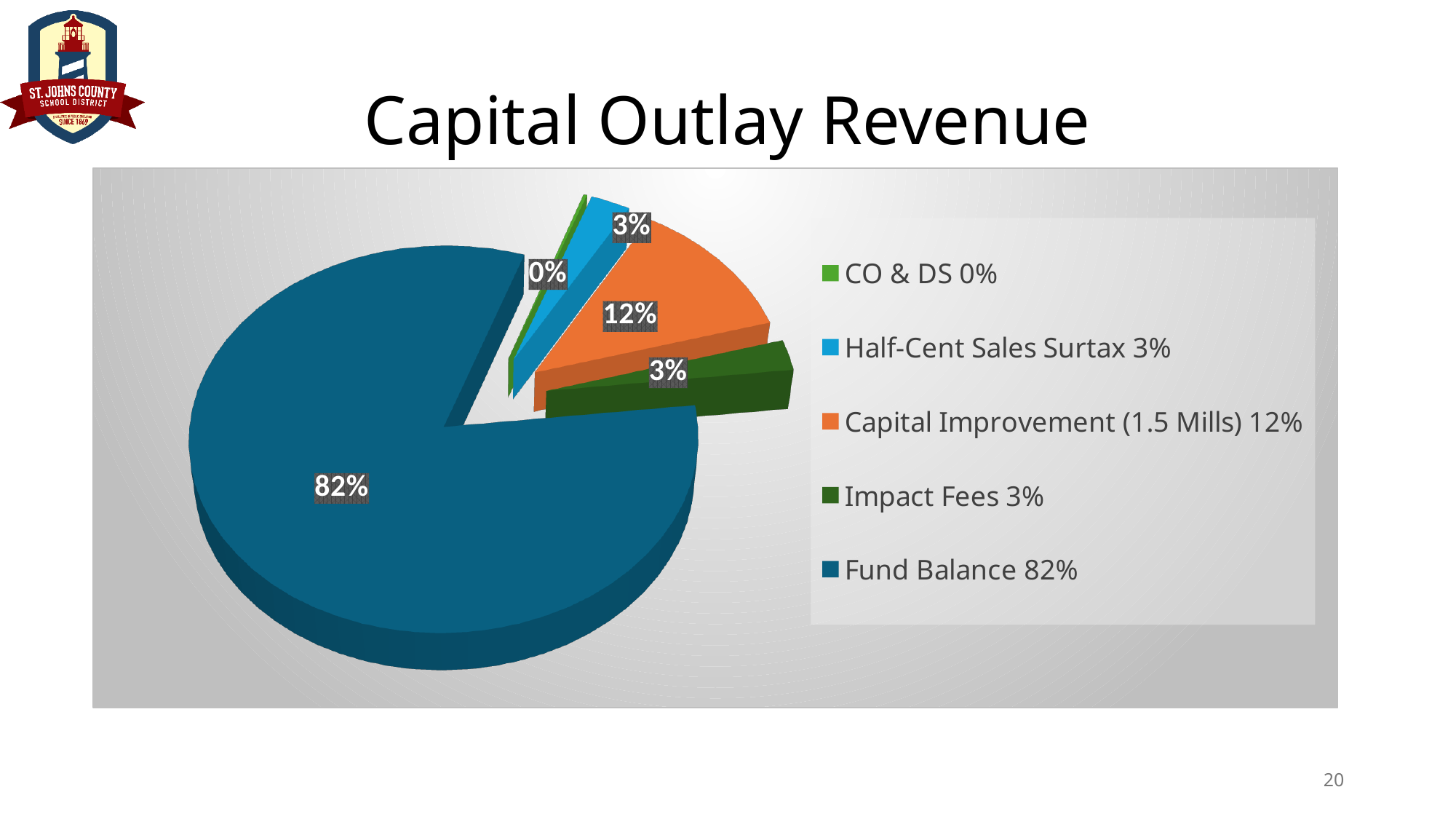
What is the title of the chart? Capital Outlay Revenue Which category has the largest share of Capital Outlay Revenue? Fund Balance What kind of chart is shown on the slide? Pie chart What share of Capital Outlay Revenue is CO & DS? 0% What share of Capital Outlay Revenue is Impact Fees? 3% What share of Capital Outlay Revenue is Capital Improvement (1.5 Mills)? 12% Which category has the smallest share of Capital Outlay Revenue? CO & DS What share of Capital Outlay Revenue is Half-Cent Sales Surtax? 3% What is the difference in percentage points between Fund Balance and Capital Improvement (1.5 Mills)? 70 How many categories does the legend list? 5 What share of Capital Outlay Revenue is Fund Balance? 82% Which is larger, the share for Capital Improvement (1.5 Mills) or the share for Impact Fees? Capital Improvement (1.5 Mills)